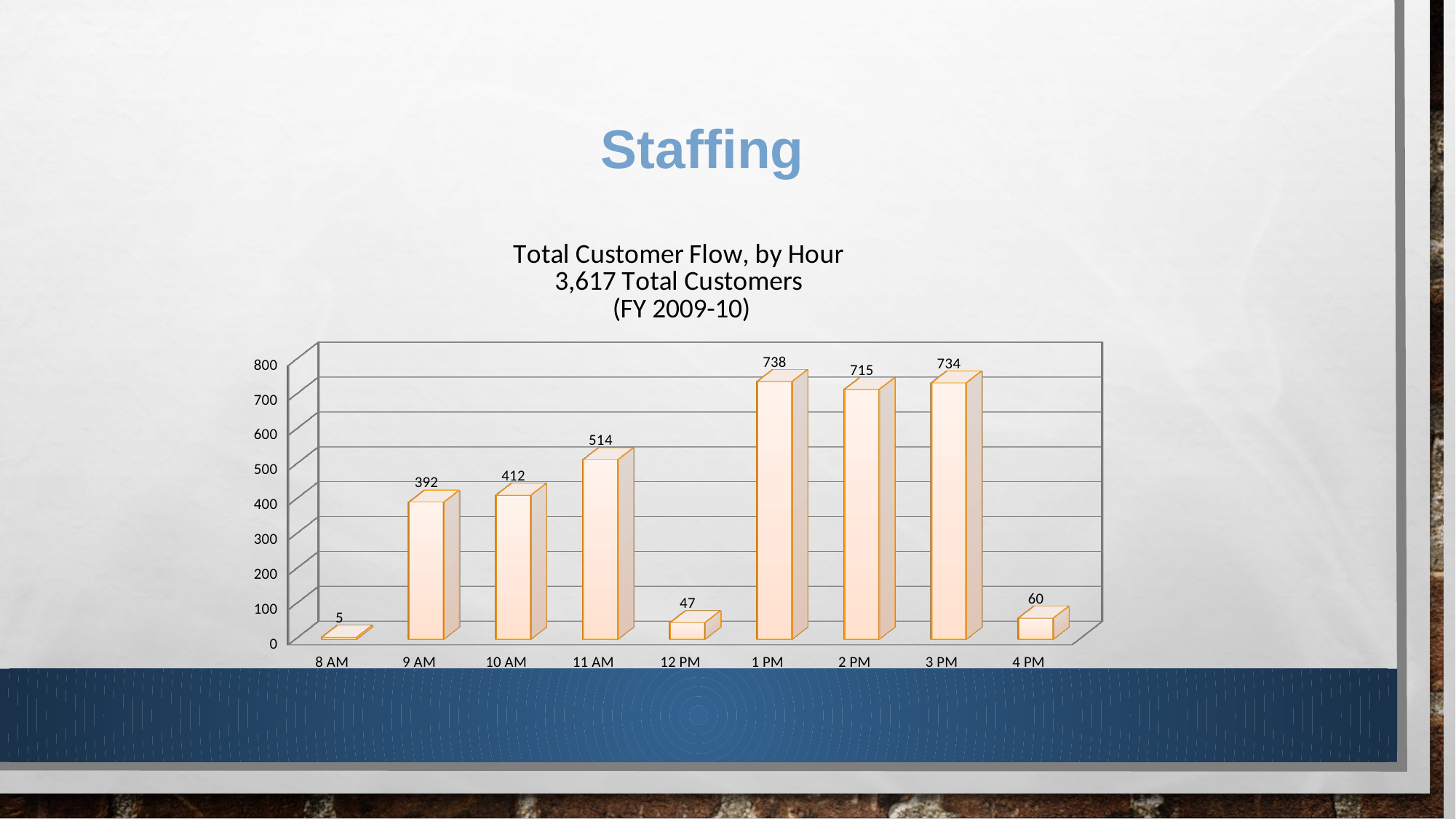
How many hours are shown on the x axis? 9 What kind of chart is shown on the slide? bar chart What is the chart's title? Total Customer Flow, by Hour 3,617 Total Customers (FY 2009-10) What is the difference between the values for 1 PM and 3 PM? 4 Which hour has the lowest customer flow? 8 AM Is the value for 2 PM greater or less than 600? greater What is the value for 11 AM? 514 What is the value for 1 PM? 738 What is the difference between the values for 11 AM and 10 AM? 102 Which hour has the highest customer flow? 1 PM Which is larger, the value for 9 AM or the value for 12 PM? 9 AM What is the value for 8 AM? 5